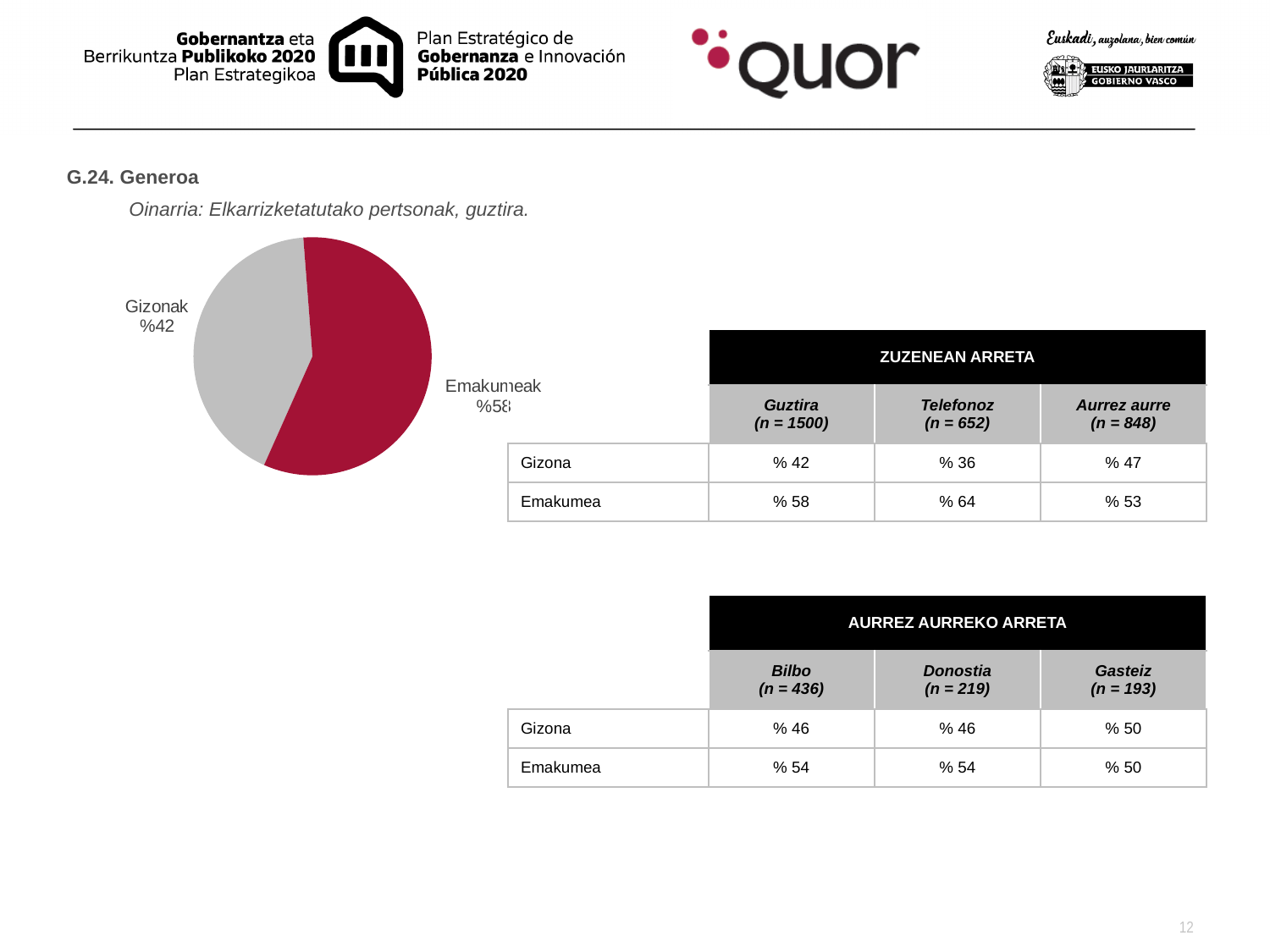
What colour is the Gizonak slice of the pie chart? grey What is the value shown for Emakumeak in the pie chart? %58 What is the value shown for Gizonak in the pie chart? %42 What share of the pie does the Emakumeak slice represent? %58 What is the difference in percentage points between the Emakumeak and Gizonak slices? 16 Which slice of the pie chart is the smallest? Gizonak Which slice of the pie chart is the largest? Emakumeak What share of the pie does the Gizonak slice represent? %42 How many slices does the pie chart have? 2 Which is larger in the pie chart, Gizonak or Emakumeak? Emakumeak What kind of chart is shown on the slide? pie chart What colour is the Emakumeak slice of the pie chart? dark red